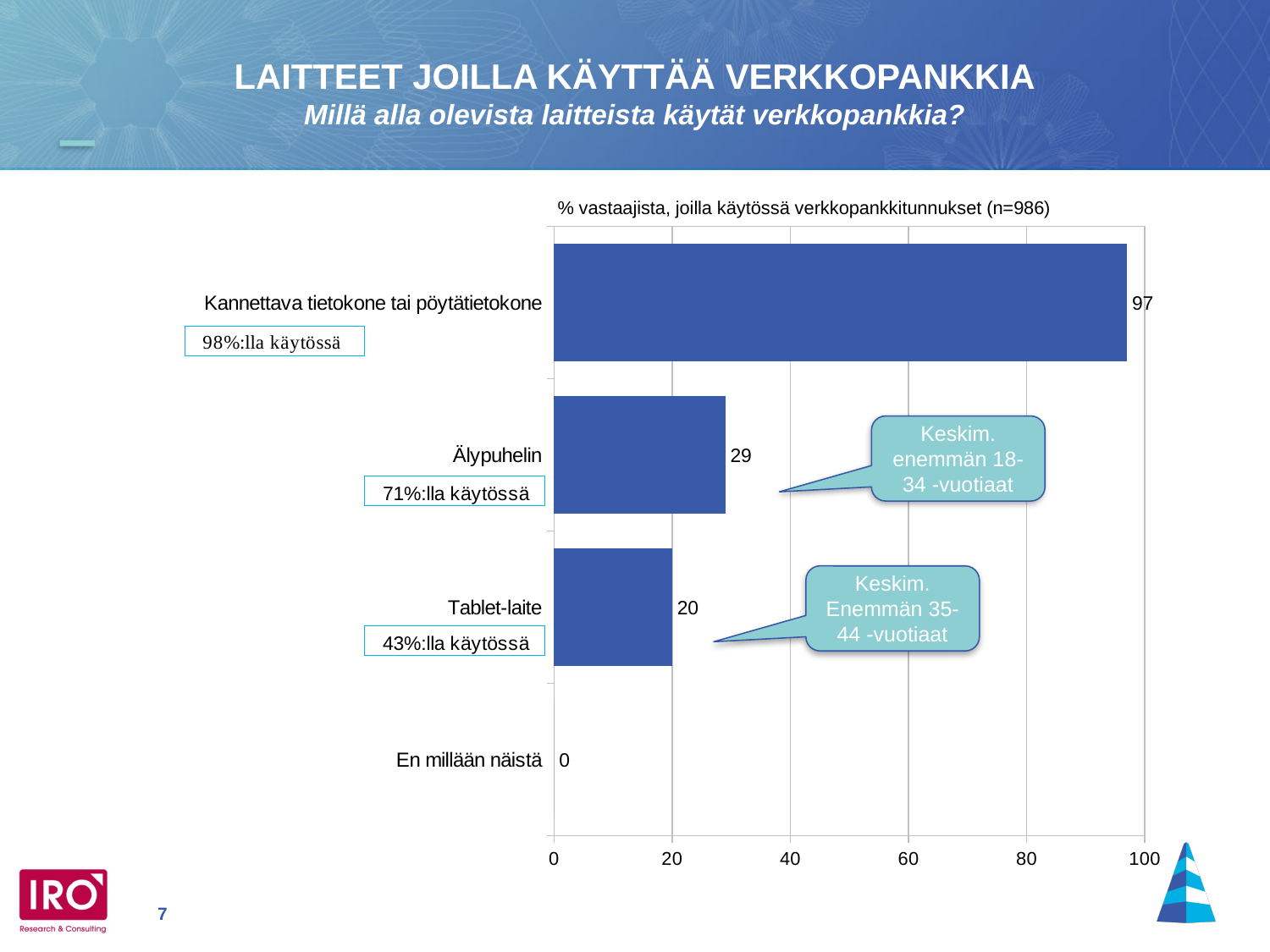
Which is larger, the value for Älypuhelin or the value for Tablet-laite? Älypuhelin What is the difference between the values for Kannettava tietokone tai pöytätietokone and Älypuhelin? 68 What is the value for En millään näistä? 0 What is the value for Kannettava tietokone tai pöytätietokone? 97 What is the difference between the values for Älypuhelin and Tablet-laite? 9 Which category has the lowest value? En millään näistä What kind of chart is shown on the slide? bar chart Which category has the highest value? Kannettava tietokone tai pöytätietokone How many categories are shown in the chart? 4 What is the value for Tablet-laite? 20 What is the title printed above the chart? % vastaajista, joilla käytössä verkkopankkitunnukset (n=986) What is the value for Älypuhelin? 29